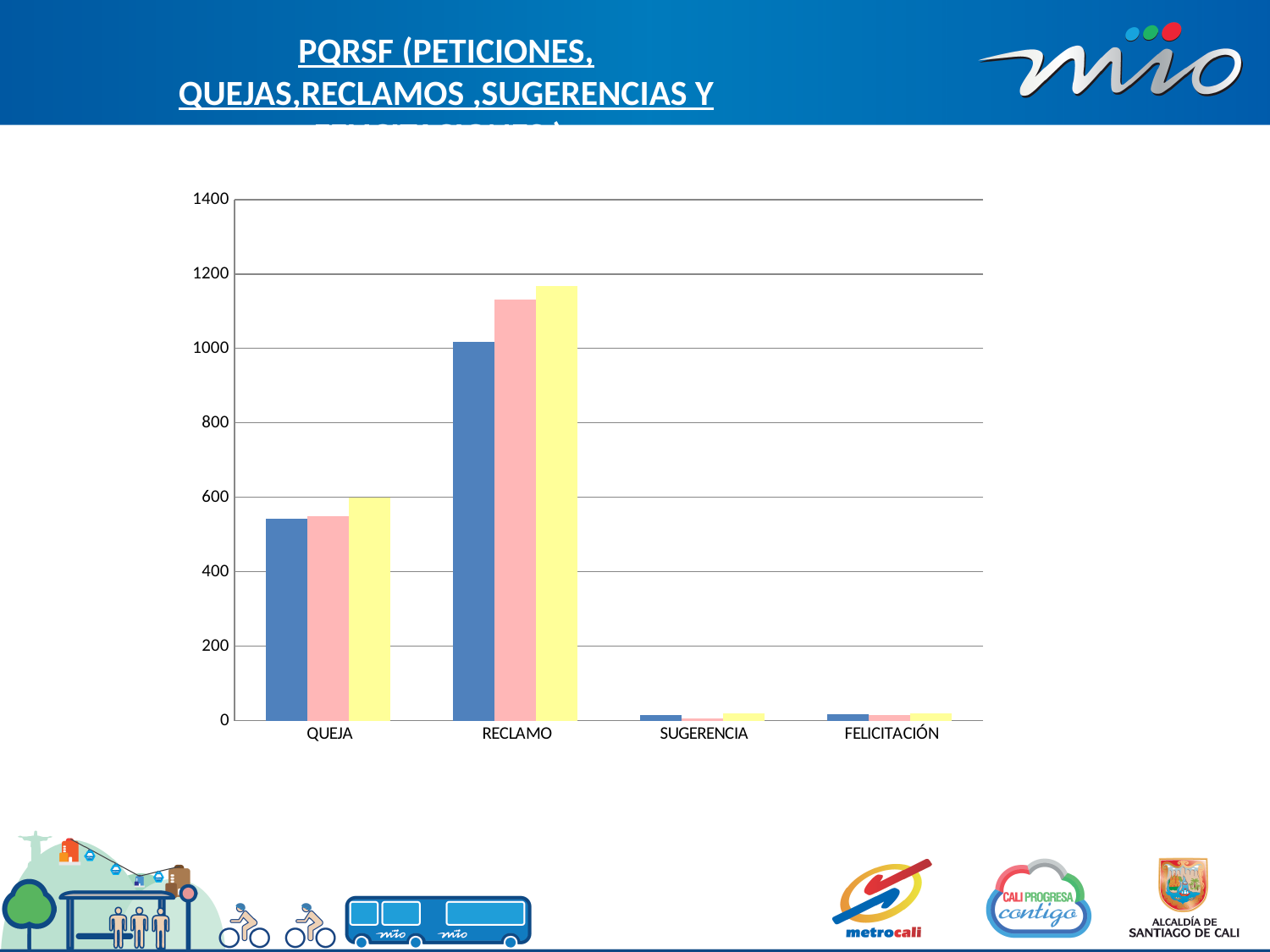
Is the value of the blue bar for QUEJA greater or less than 400? greater What is the highest value shown on the y axis of the chart? 1400 Is the value of the blue bar for QUEJA greater or less than 600? less Which is larger, the blue bar for QUEJA or the blue bar for RECLAMO? RECLAMO How many bars are plotted for each category in the chart? 3 Is the value of the yellow bar for RECLAMO greater or less than 1200? less Which is larger, the yellow bar for RECLAMO or the yellow bar for SUGERENCIA? RECLAMO How many categories are shown on the x axis of the chart? 4 What kind of chart is shown on the slide? bar chart Which category has the highest bars in the chart? RECLAMO